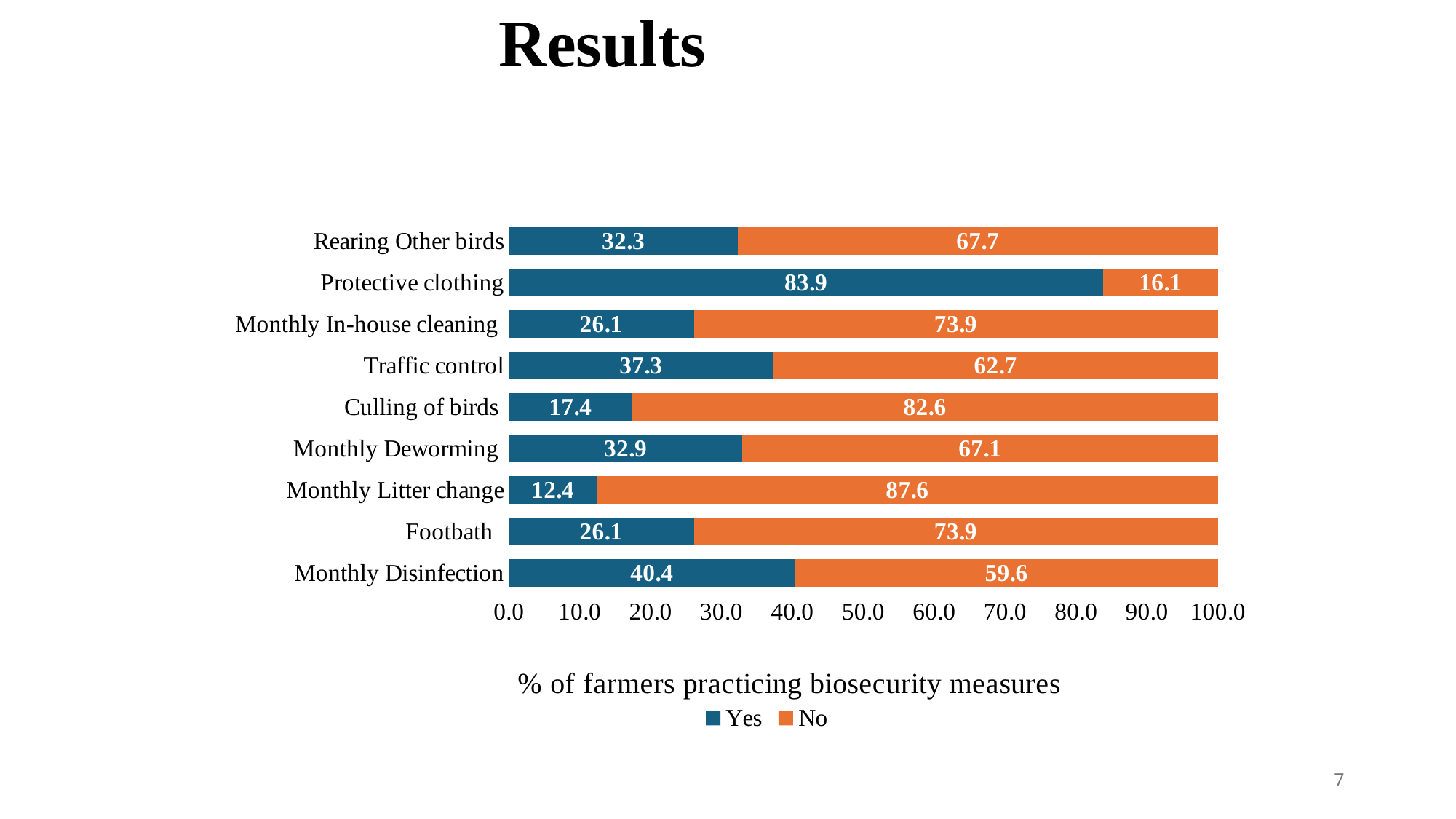
How many categories are shown on the chart? 9 What is the difference between the "No" value for Culling of birds and the "No" value for Traffic control? 19.9 How many series does the legend list? 2 Which is larger: the "Yes" value for Traffic control or the "Yes" value for Monthly Deworming? Traffic control What is the "Yes" value for Protective clothing? 83.9 What kind of chart is shown on the slide? Stacked bar chart What is the title of the chart? % of farmers practicing biosecurity measures Which category has the highest "Yes" value? Protective clothing What is the "Yes" value for Monthly Disinfection? 40.4 What is the "No" value for Monthly Litter change? 87.6 Which category has the lowest "Yes" value? Monthly Litter change What is the total of the stacked bar for Footbath? 100.0